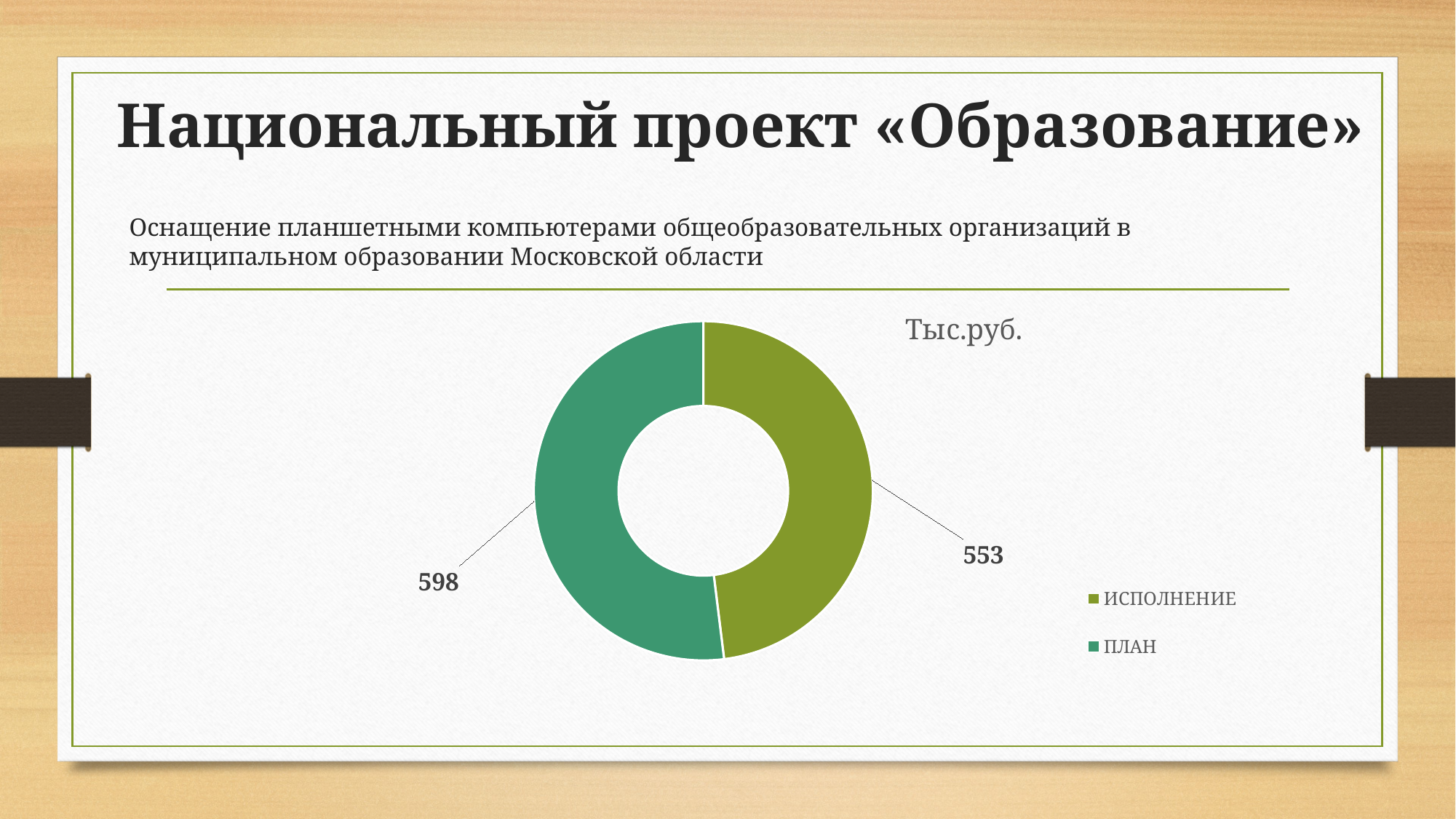
Which category has the highest value on the chart? ПЛАН What is the value for ПЛАН on the chart? 598 What is the total of the two values shown on the chart? 1151 What is the title shown above the chart? Тыс.руб. What kind of chart is shown on the slide? doughnut chart What is the difference between the values for ПЛАН and ИСПОЛНЕНИЕ? 45 Which category has the lowest value on the chart? ИСПОЛНЕНИЕ How many categories are shown on the chart? 2 What is the value for ИСПОЛНЕНИЕ on the chart? 553 How many entries does the chart legend list? 2 Which is larger, the value for ИСПОЛНЕНИЕ or the value for ПЛАН? ПЛАН